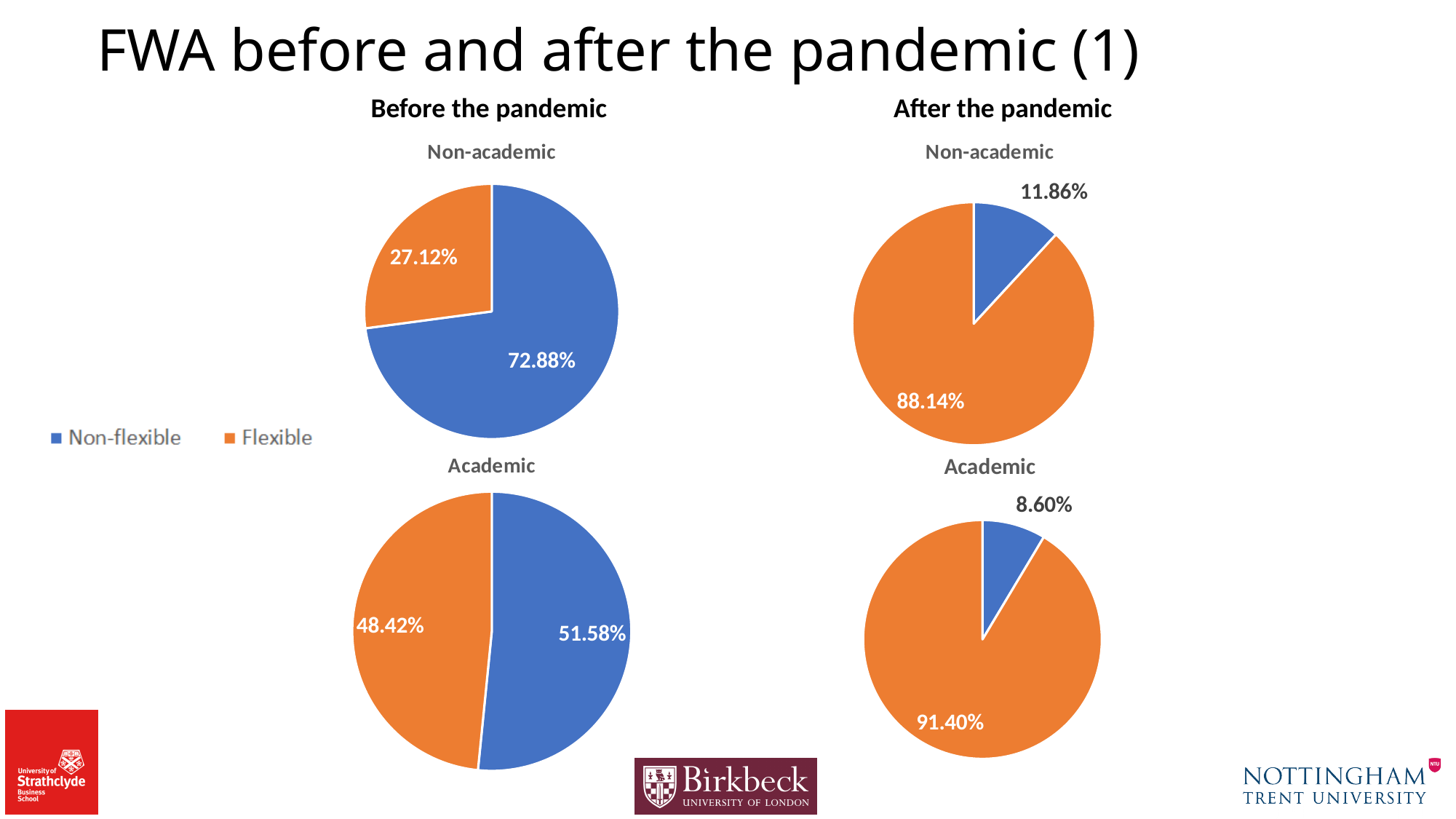
In the 'Before the pandemic' Academic pie chart, what share is Non-flexible? 51.58% In the 'Before the pandemic' Non-academic pie chart, which slice is the largest? Non-flexible How many series does the legend list? 2 In the 'After the pandemic' Academic pie chart, which slice is larger, Flexible or Non-flexible? Flexible In the 'After the pandemic' Academic pie chart, what share is Flexible? 91.40% Which colour represents Flexible in the legend? Orange In the 'Before the pandemic' Non-academic pie chart, what share is Non-flexible? 72.88% In the 'After the pandemic' Non-academic pie chart, what share is Non-flexible? 11.86% What type of chart is used on this slide? Pie chart In the 'Before the pandemic' Non-academic pie chart, what share is Flexible? 27.12% In the 'After the pandemic' Non-academic pie chart, what is the difference between the Flexible and Non-flexible shares? 76.28% In the 'Before the pandemic' Academic pie chart, what is the difference between the Non-flexible and Flexible shares? 3.16%